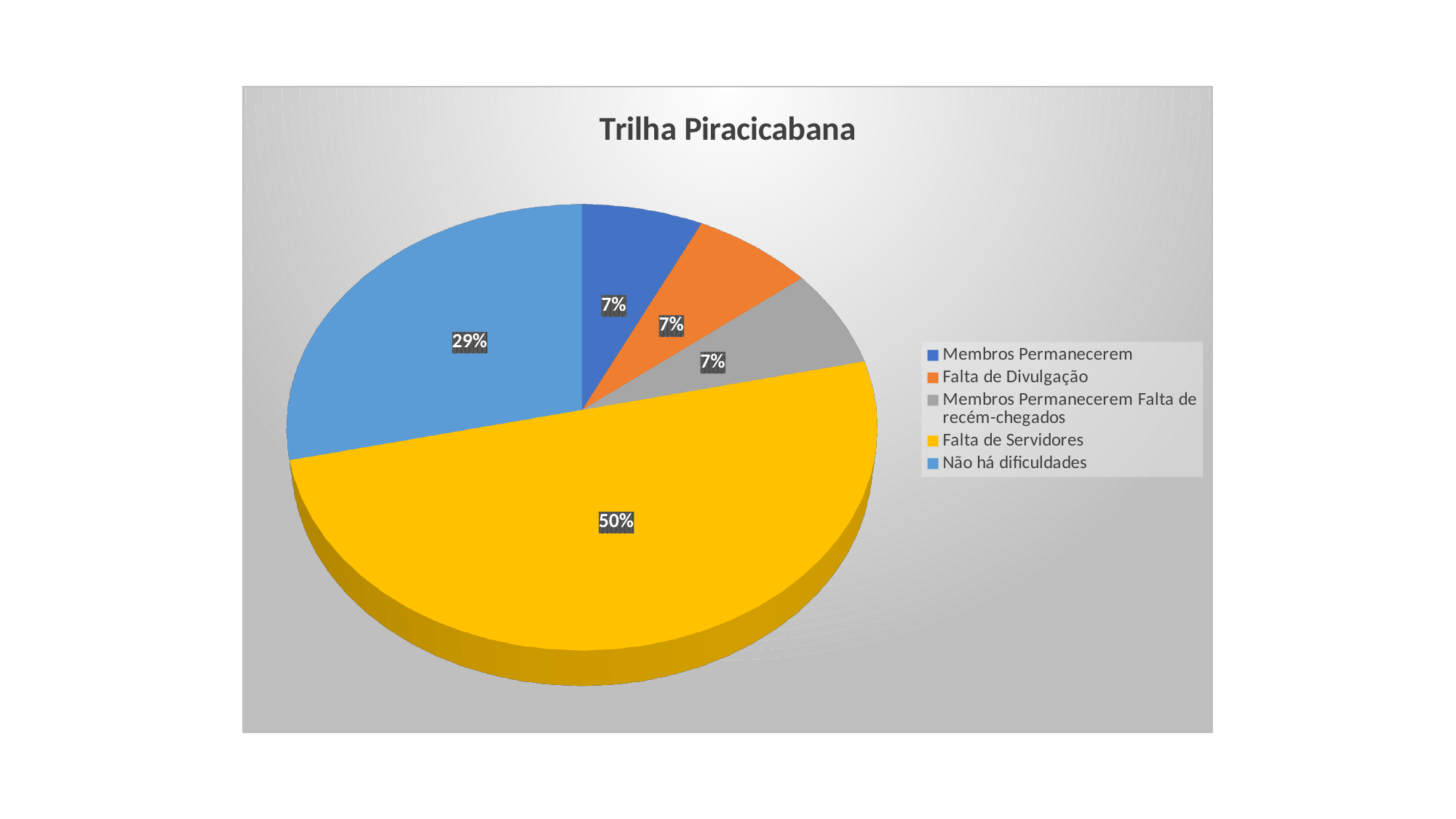
What is the difference between the share for Falta de Servidores and the share for Não há dificuldades? 21% What share of the pie does Membros Permanecerem represent? 7% What colour is the slice for Falta de Servidores? Yellow How many categories does the legend list? 5 What share of the pie does Não há dificuldades represent? 29% What is the combined share of Falta de Servidores and Não há dificuldades? 79% Which is larger, the slice for Não há dificuldades or the slice for Falta de Divulgação? Não há dificuldades Which category has the largest slice of the pie? Falta de Servidores What share of the pie does Falta de Divulgação represent? 7% What is the title of the chart? Trilha Piracicabana What kind of chart is shown on the slide? Pie chart